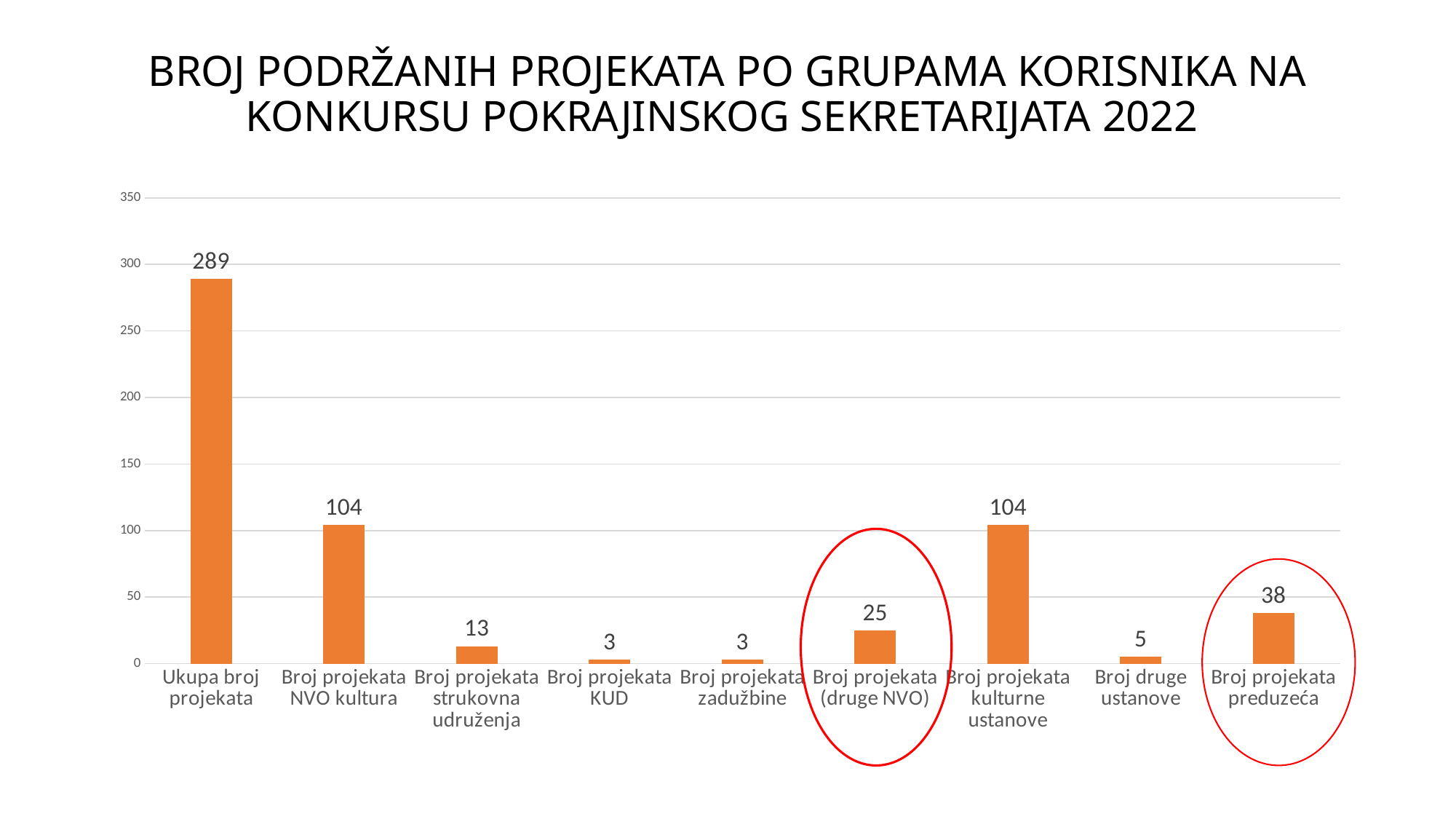
What is the value for Broj projekata preduzeća? 38 Is the value for Broj projekata kulturne ustanove greater or less than 50? greater What is the value for Ukupa broj projekata? 289 What is the value for Broj projekata NVO kultura? 104 What is the difference between Ukupa broj projekata and Broj projekata kulturne ustanove? 185 Which is larger, Broj projekata strukovna udruženja or Broj druge ustanove? Broj projekata strukovna udruženja What is the value for Broj projekata (druge NVO)? 25 What is the difference between Broj projekata preduzeća and Broj projekata (druge NVO)? 13 What kind of chart is shown on the slide? bar chart How many categories are shown on the x axis? 9 Which category has the highest value? Ukupa broj projekata What is the value for Broj projekata strukovna udruženja? 13